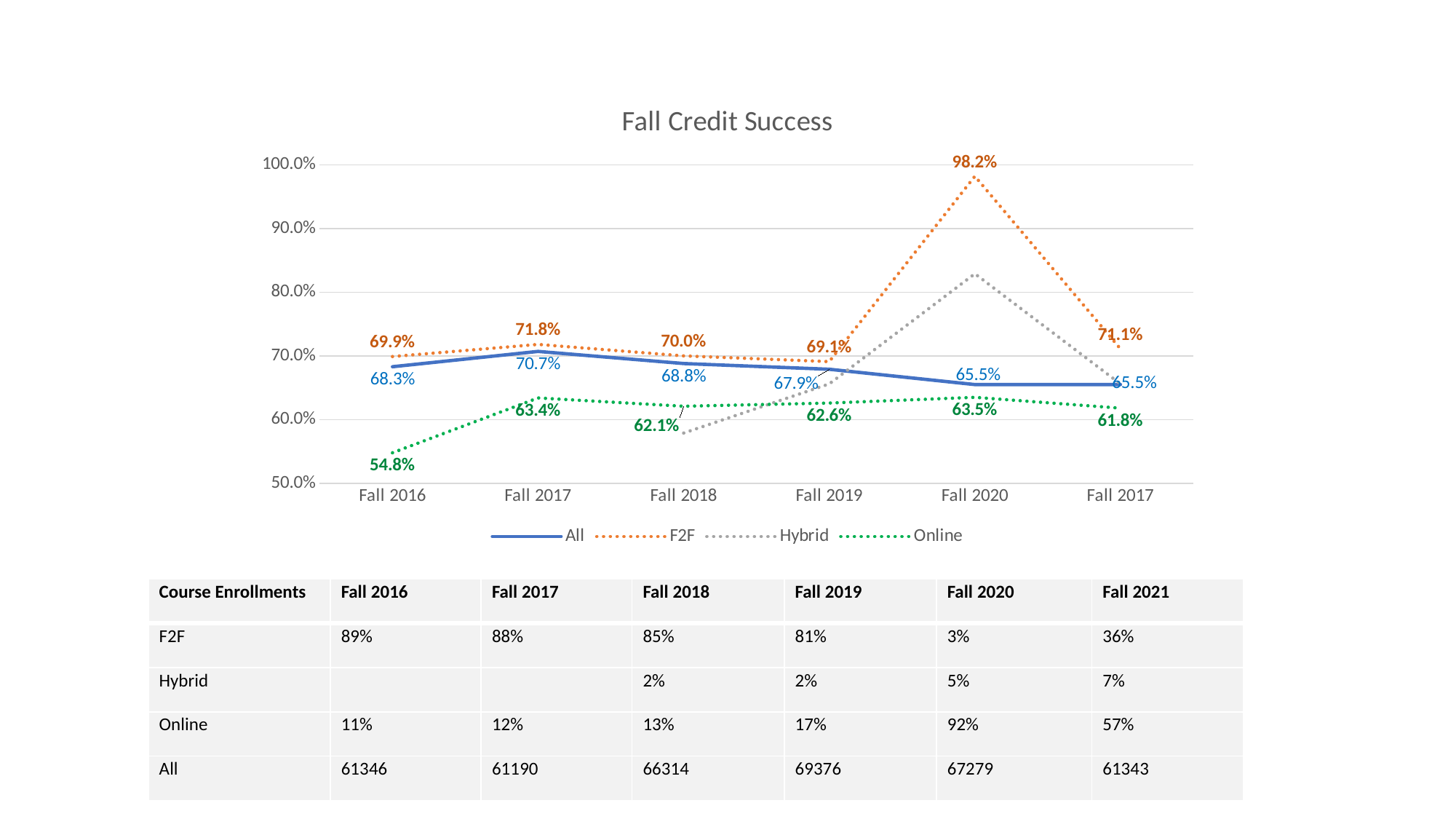
What type of chart is shown on the slide? line chart What is the All value for Fall 2019 in the Fall Credit Success chart? 67.9% In which period does the F2F series reach its highest value? Fall 2020 Does the All series rise or fall from Fall 2017 to Fall 2020? fall How many series does the legend of the Fall Credit Success chart list? 4 What is the Online value for Fall 2016 in the Fall Credit Success chart? 54.8% How many periods are shown on the x axis of the Fall Credit Success chart? 6 What is the difference between the F2F and All values for Fall 2017? 1.1% What is the F2F value for Fall 2020 in the Fall Credit Success chart? 98.2% Is the Hybrid value for Fall 2020 greater or less than 80.0%? greater In which period does the Online series have its lowest value? Fall 2016 Which is larger in Fall 2018, the F2F value or the Online value? F2F